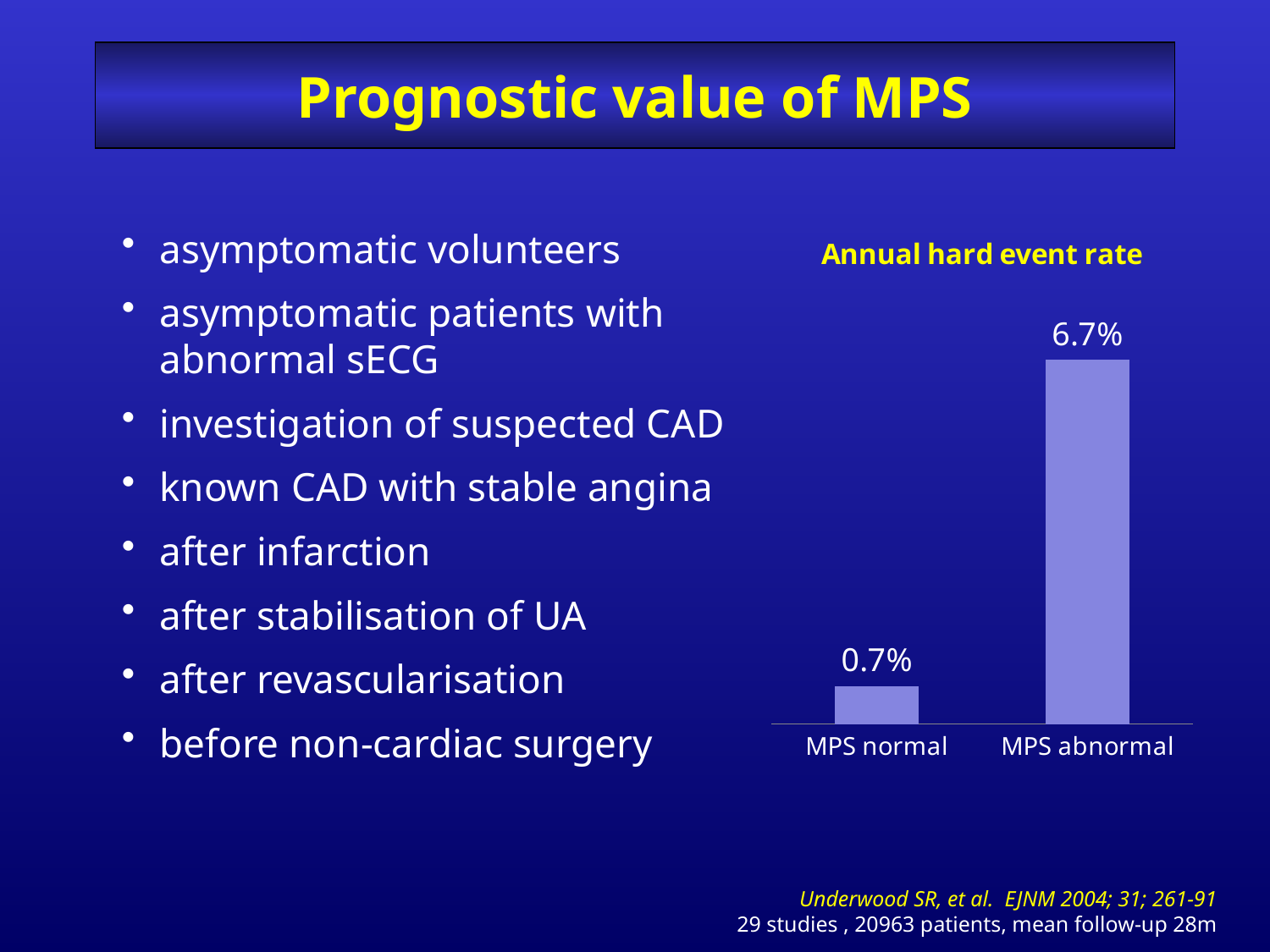
How many categories are shown in the chart? 2 Which category has the higher annual hard event rate? MPS abnormal What is the difference in annual hard event rate between MPS abnormal and MPS normal? 6.0% Which category has the lower annual hard event rate? MPS normal What is the title of the chart? Annual hard event rate Is the annual hard event rate larger for MPS normal or MPS abnormal? MPS abnormal What is the annual hard event rate for MPS abnormal? 6.7% What is the annual hard event rate for MPS normal? 0.7% What kind of chart is shown on the slide? Bar chart What are the two category labels on the x axis of the chart? MPS normal, MPS abnormal